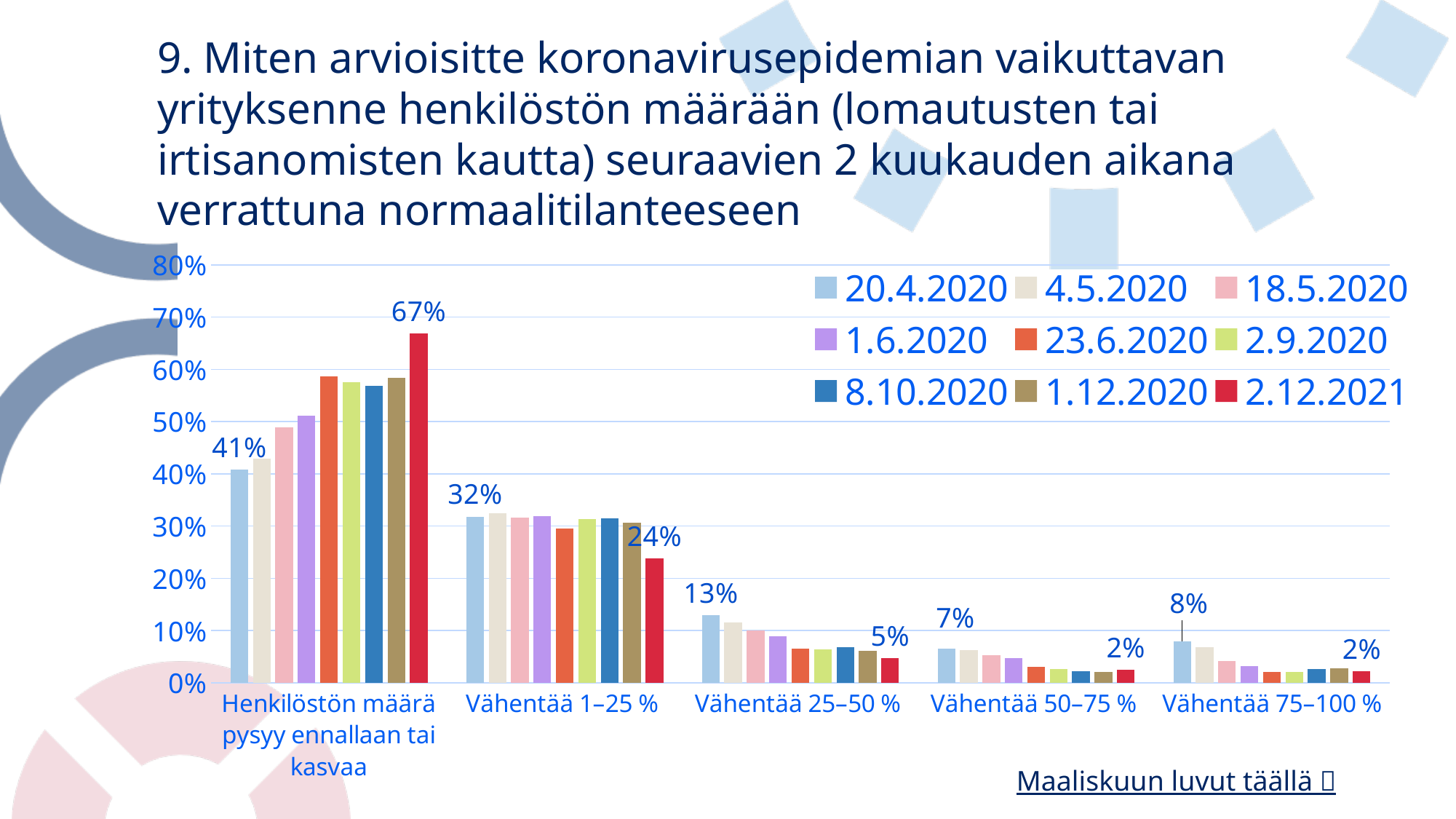
What is the value for 20.4.2020 in the category 'Vähentää 25–50 %'? 13% What is the difference between the 2.12.2021 and 20.4.2020 values in the category 'Henkilöstön määrä pysyy ennallaan tai kasvaa'? 26 percentage points What is the difference between the 20.4.2020 and 2.12.2021 values in the category 'Vähentää 1–25 %'? 8 percentage points What is the value for 20.4.2020 in the category 'Henkilöstön määrä pysyy ennallaan tai kasvaa'? 41% Is the value for 23.6.2020 in the category 'Henkilöstön määrä pysyy ennallaan tai kasvaa' greater or less than 50%? greater Which category has the highest value for the 2.12.2021 series? Henkilöstön määrä pysyy ennallaan tai kasvaa What is the value for 2.12.2021 in the category 'Henkilöstön määrä pysyy ennallaan tai kasvaa'? 67% How many series does the legend list? 9 Which series is shown in red in the legend? 2.12.2021 What is the value for 2.12.2021 in the category 'Vähentää 1–25 %'? 24% How many categories are shown on the x axis? 5 What kind of chart is shown on the slide? bar chart